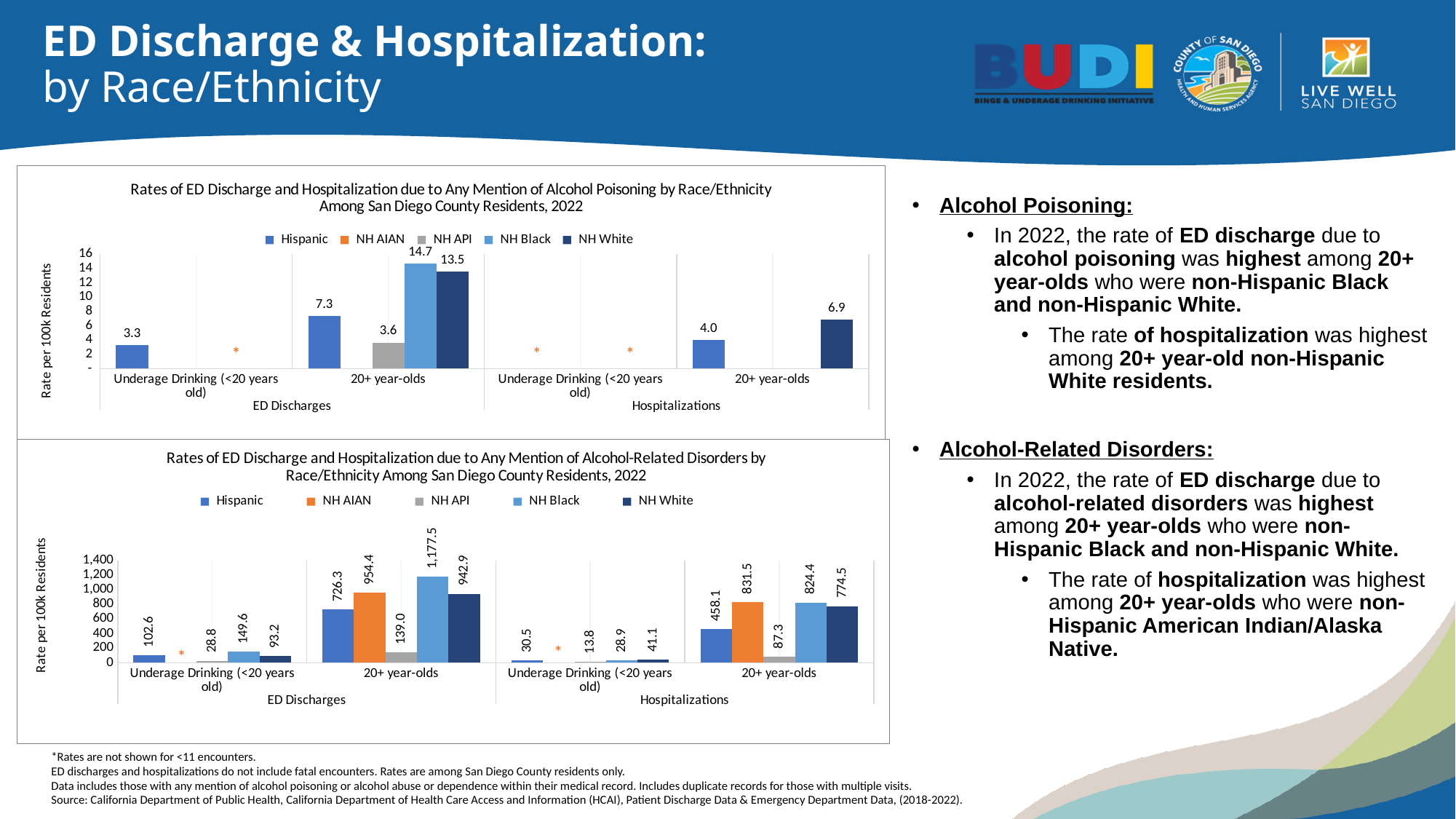
In the top chart (alcohol poisoning), what is the ED discharge rate for NH Black residents aged 20+? 14.7 In the top chart (alcohol poisoning), which race/ethnicity group has the highest ED discharge rate among 20+ year-olds? NH Black In the top chart (alcohol poisoning), what is the hospitalization rate for NH White residents aged 20+? 6.9 What type of chart is the top chart on the slide? Bar chart In the bottom chart (alcohol-related disorders), what is the difference between the 20+ ED discharge rates for NH AIAN and Hispanic residents? 228.1 In the bottom chart (alcohol-related disorders), what is the ED discharge rate for NH Black residents aged 20+? 1,177.5 In the bottom chart (alcohol-related disorders), what is the underage (<20 years old) hospitalization rate for NH White residents? 41.1 In the top chart (alcohol poisoning), how many series does the legend list? 5 In the bottom chart (alcohol-related disorders), which race/ethnicity group has the lowest ED discharge rate among 20+ year-olds? NH API In the bottom chart (alcohol-related disorders), which is larger: the 20+ hospitalization rate for Hispanic residents or for NH White residents? NH White In the top chart (alcohol poisoning), what is the difference between the ED discharge rates for NH Black and NH White residents aged 20+? 1.2 In the bottom chart (alcohol-related disorders), what is the hospitalization rate for NH AIAN residents aged 20+? 831.5